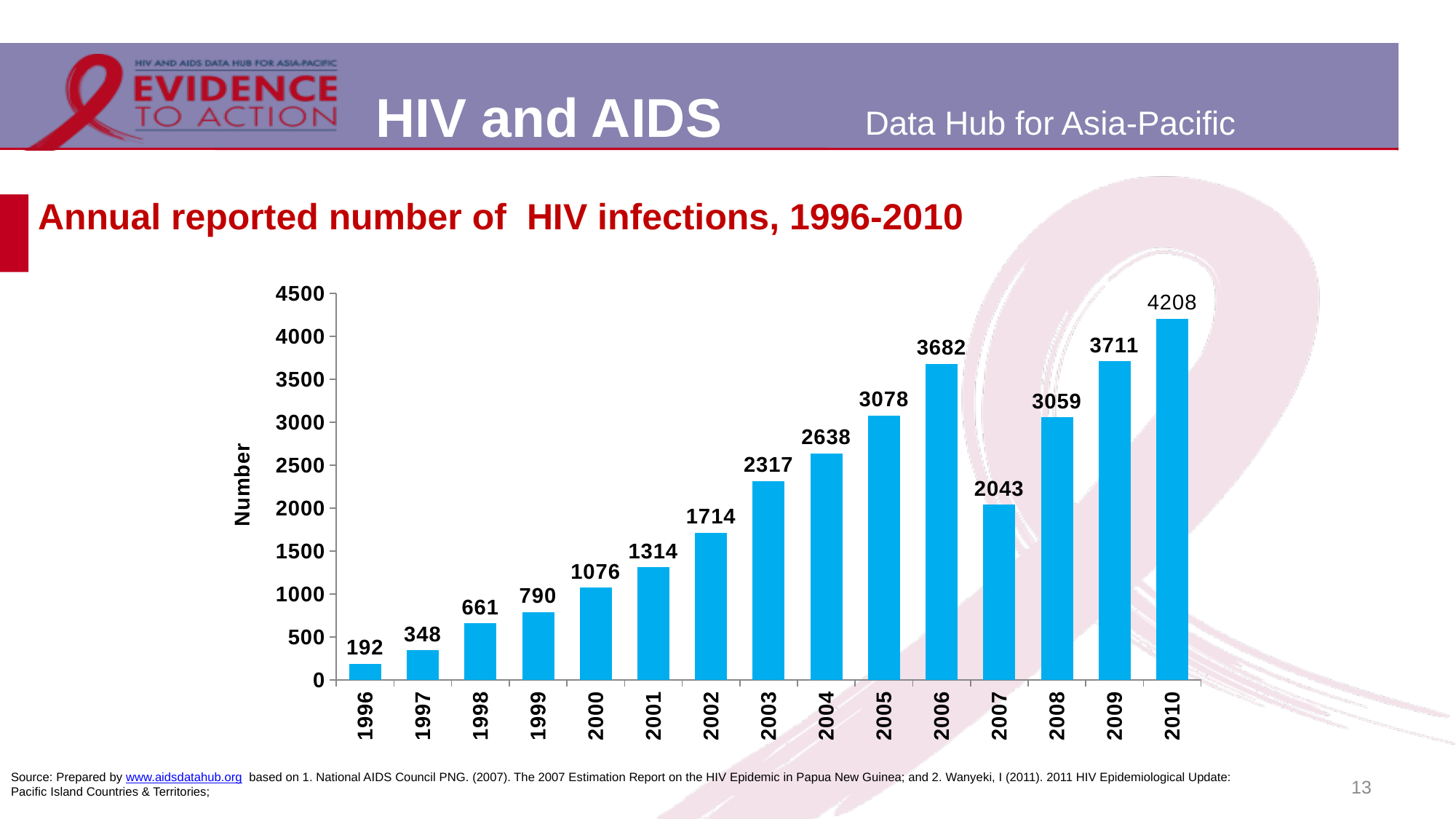
What kind of chart is used to show the annual reported number of HIV infections? Bar chart What is the label of the y axis of the chart? Number Is the reported number of HIV infections in 2004 greater or less than 2500? greater Which year has a larger reported number of HIV infections, 2005 or 2008? 2005 Which year has the lowest reported number of HIV infections? 1996 What is the annual reported number of HIV infections in 2003? 2317 What is the annual reported number of HIV infections in 1996? 192 What is the annual reported number of HIV infections in 2007? 2043 Which year has the highest reported number of HIV infections? 2010 What is the difference between the reported number of HIV infections in 2006 and in 2007? 1639 How many years are shown on the x axis of the chart? 15 What is the difference between the reported number of HIV infections in 2010 and in 2009? 497